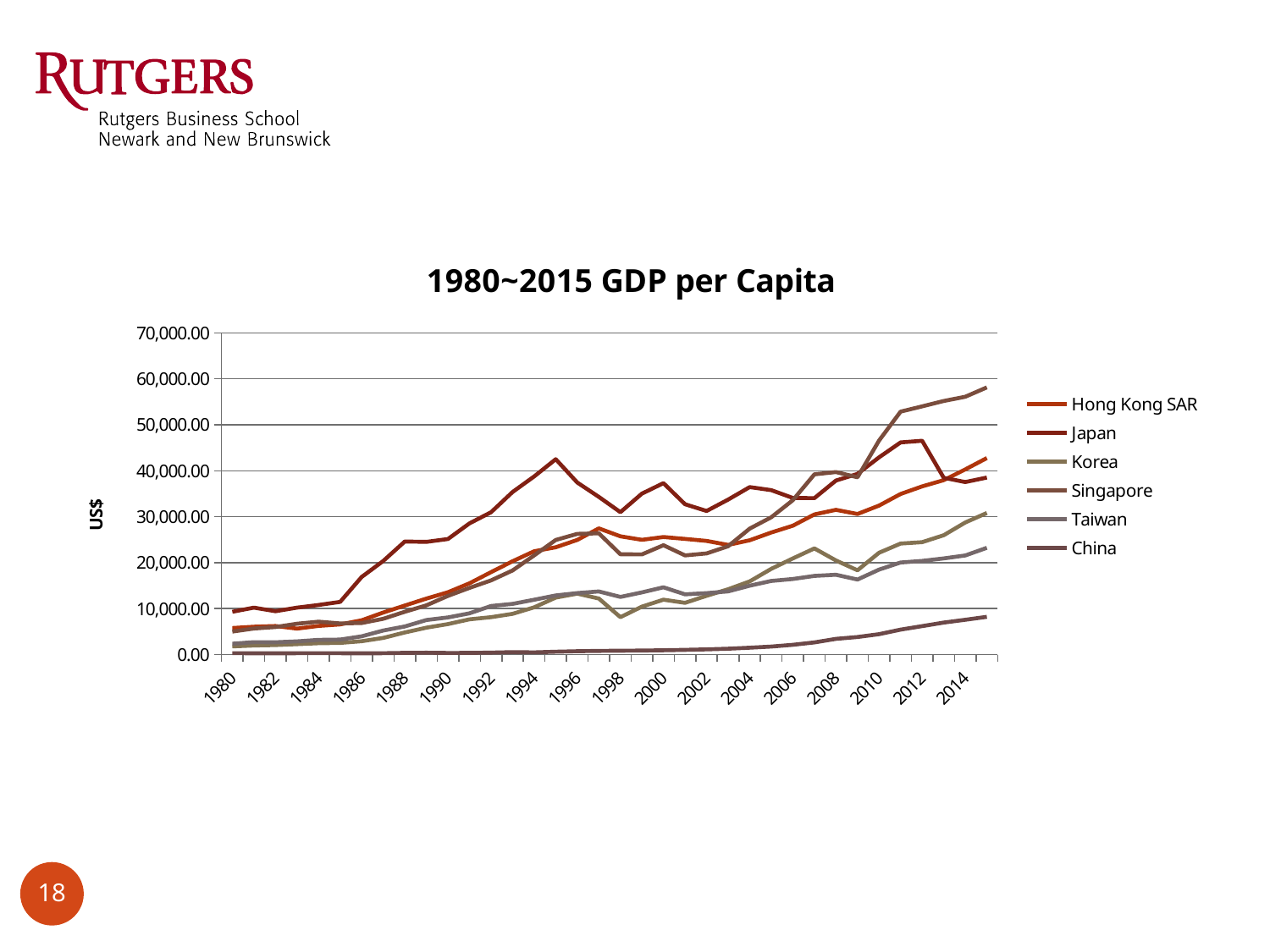
Which series has the lowest GDP per capita throughout the period? China Is Japan's peak value in the mid-1990s greater or less than 40,000.00? greater Is the value for Singapore in 2014 greater or less than 50,000.00? greater Which series has the highest GDP per capita at the end of the period (2015)? Singapore How many series does the legend of the chart list? 6 In 2014, which is larger, the value for Korea or the value for Taiwan? Korea What is the label on the vertical axis of the chart? US$ Which series was the highest in 1990? Japan Does the value for China rise or fall from 1980 to 2015? rise What is the title of the chart? 1980~2015 GDP per Capita Is the value for China in 2014 greater or less than 10,000.00? less What kind of chart is shown on the slide? line chart